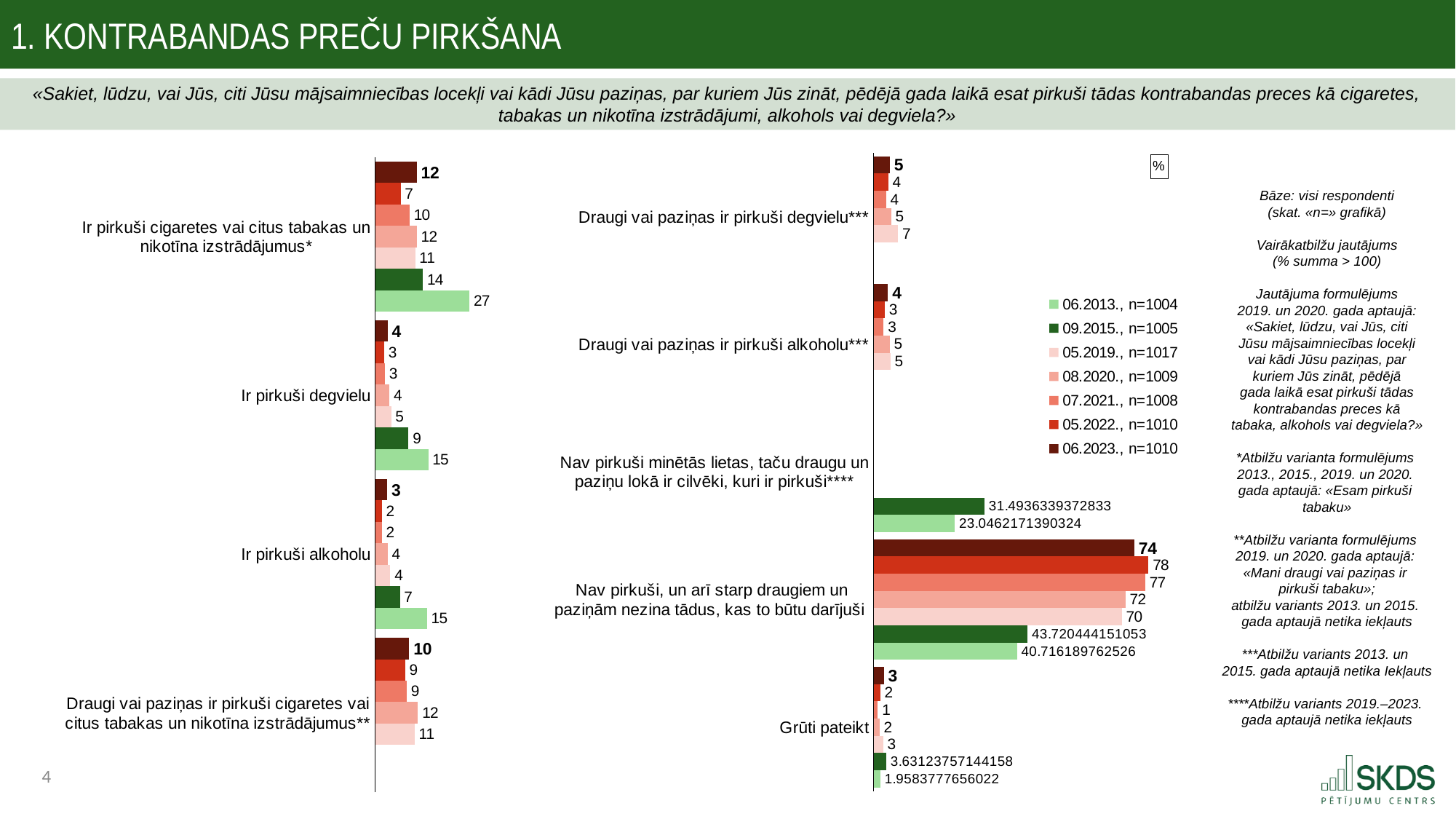
What kind of chart is used on this slide? Bar chart In the left chart, what is the value for 'Ir pirkuši degvielu' in the 06.2023., n=1010 series? 4 In the left chart, which is larger for 'Draugi vai paziņas ir pirkuši cigaretes vai citus tabakas un nikotīna izstrādājumus**': the 08.2020. value or the 06.2023. value? 08.2020. In the right chart, what is the value for 'Grūti pateikt' in the 07.2021., n=1008 series? 1 In the left chart, what is the difference between the 06.2013. and 06.2023. values for 'Ir pirkuši cigaretes vai citus tabakas un nikotīna izstrādājumus*'? 15 In the right chart, which survey wave has the lowest value for 'Nav pirkuši, un arī starp draugiem un paziņām nezina tādus, kas to būtu darījuši'? 06.2013., n=1004 In the right chart, what is the value for 'Nav pirkuši, un arī starp draugiem un paziņām nezina tādus, kas to būtu darījuši' in the 05.2022., n=1010 series? 78 In the right chart, what is the difference between the 05.2022. and 05.2019. values for 'Nav pirkuši, un arī starp draugiem un paziņām nezina tādus, kas to būtu darījuši'? 8 In the left chart, which survey wave has the highest value for 'Ir pirkuši alkoholu'? 06.2013., n=1004 How many series does the legend list? 7 How many categories are shown in the right chart? 5 In the left chart, what is the value for 'Ir pirkuši cigaretes vai citus tabakas un nikotīna izstrādājumus*' in the 06.2013., n=1004 series? 27